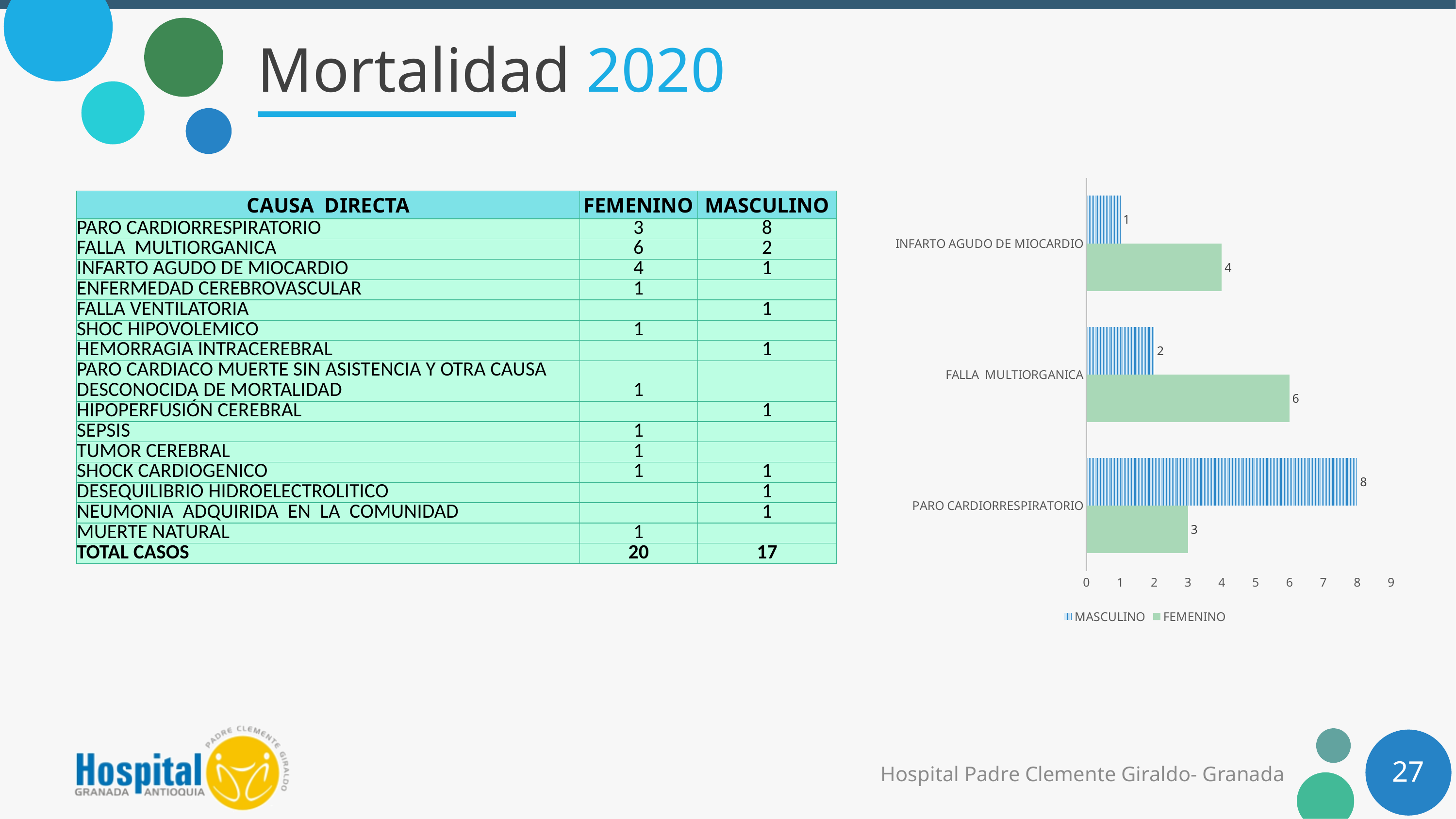
What is the difference between the MASCULINO and FEMENINO values for PARO CARDIORRESPIRATORIO? 5 Which category has the highest MASCULINO value in the chart? PARO CARDIORRESPIRATORIO Which series in the chart is shown with a striped blue pattern? MASCULINO What is the FEMENINO value for PARO CARDIORRESPIRATORIO in the chart? 3 How many series does the chart legend list? 2 What kind of chart is shown on the slide? Bar chart What is the MASCULINO value for PARO CARDIORRESPIRATORIO in the chart? 8 How many categories are shown in the chart? 3 What is the FEMENINO value for FALLA MULTIORGANICA in the chart? 6 Which category has the lowest FEMENINO value in the chart? PARO CARDIORRESPIRATORIO What is the MASCULINO value for INFARTO AGUDO DE MIOCARDIO in the chart? 1 For FALLA MULTIORGANICA, which is larger: the FEMENINO or the MASCULINO value? FEMENINO